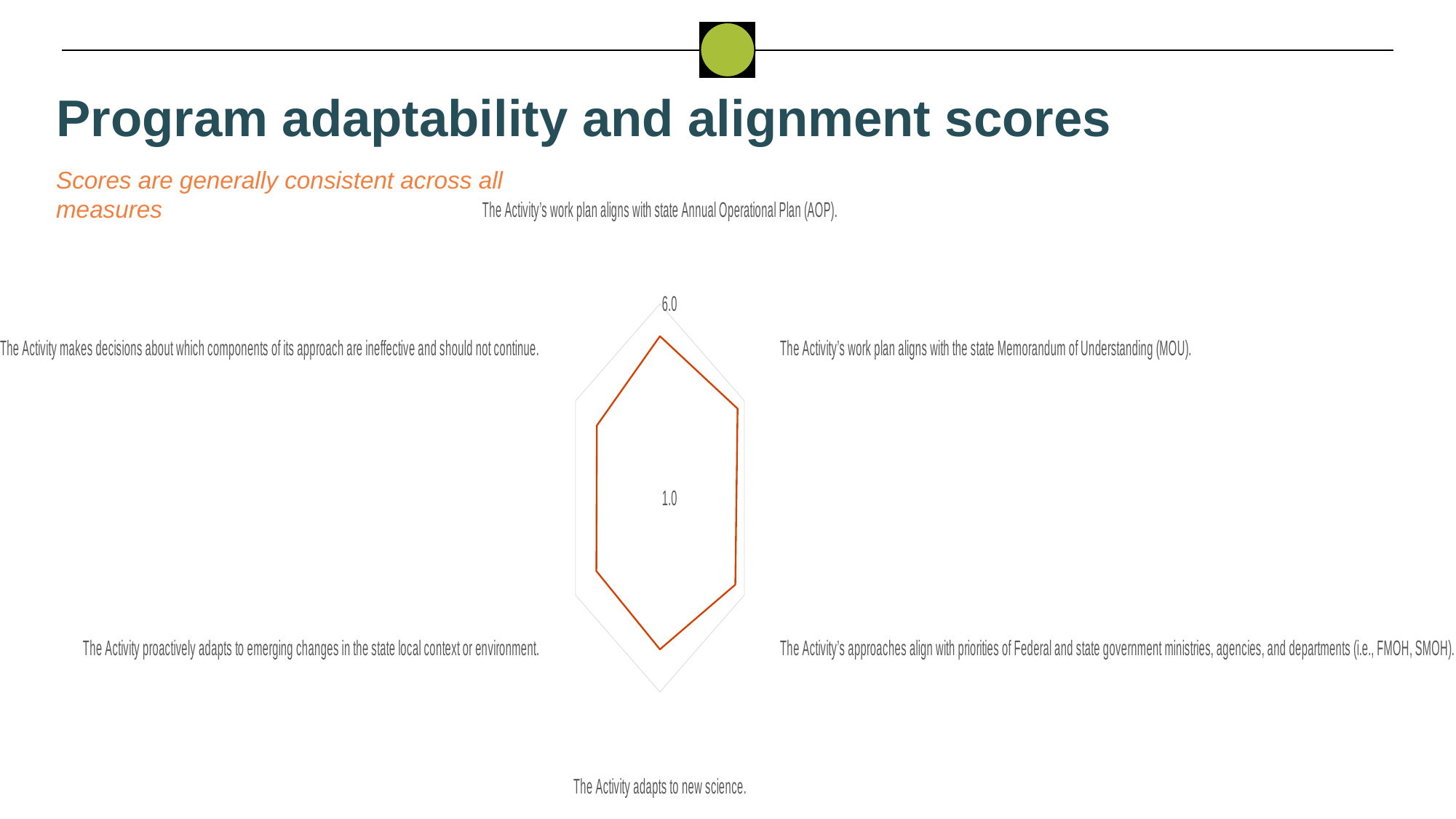
What kind of chart is shown on the slide? Radar chart Is the value for "The Activity's work plan aligns with the state Memorandum of Understanding (MOU)." greater or less than 1.0? greater What is the highest value shown on the radar chart's axis scale? 6.0 How many categories (axes) does the radar chart have? 6 Is the value for "The Activity adapts to new science." greater or less than 6.0? less Which category label appears at the top of the radar chart? The Activity's work plan aligns with state Annual Operational Plan (AOP). Is the value for "The Activity's work plan aligns with state Annual Operational Plan (AOP)." greater or less than 1.0? greater What is the title of the slide containing the radar chart? Program adaptability and alignment scores